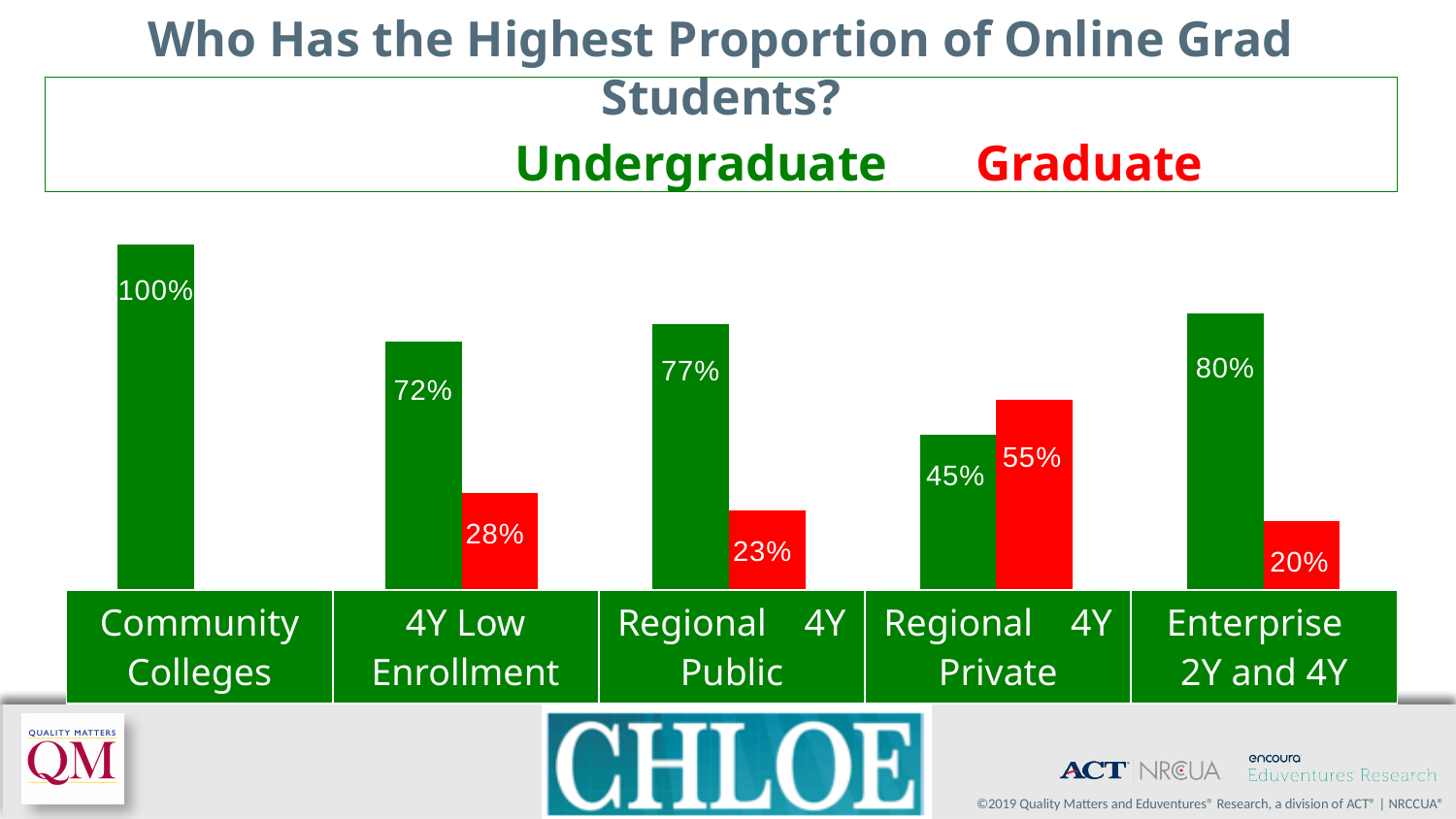
What colour represents the Graduate series? Red Which is larger for Regional 4Y Private, the Undergraduate value or the Graduate value? Graduate What kind of chart is shown on the slide? Bar chart What is the Graduate value for Enterprise 2Y and 4Y? 20% What is the Undergraduate value for Regional 4Y Public? 77% What is the difference between the Undergraduate and Graduate values for 4Y Low Enrollment? 44% Which category has the highest Undergraduate value? Community Colleges What is the Graduate value for Regional 4Y Private? 55% How many categories are shown on the x axis? 5 Which category has the lowest Undergraduate value? Regional 4Y Private How many series does the legend list? 2 Which category has the highest Graduate value? Regional 4Y Private